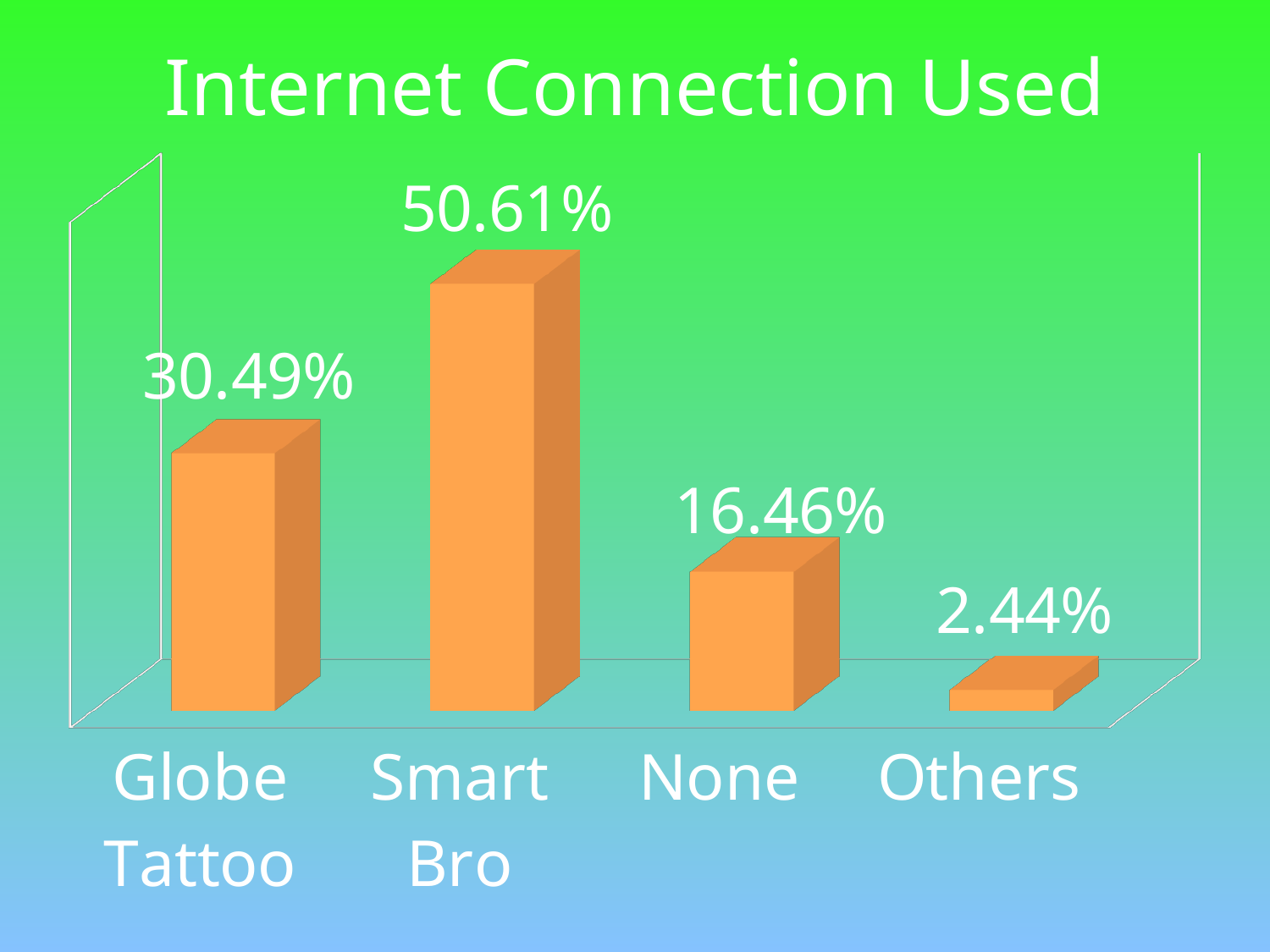
What is the value for Globe Tattoo? 30.49% What kind of chart is shown on the slide? Bar chart What is the difference between the values for None and Others? 14.02% What is the difference between the values for Smart Bro and Globe Tattoo? 20.12% Which category has the lowest value? Others What is the value for Others? 2.44% Which is larger, the value for Globe Tattoo or the value for None? Globe Tattoo Which category has the highest value? Smart Bro How many categories are shown in the chart? 4 What is the value for None? 16.46% What is the title of the chart? Internet Connection Used What is the value for Smart Bro? 50.61%